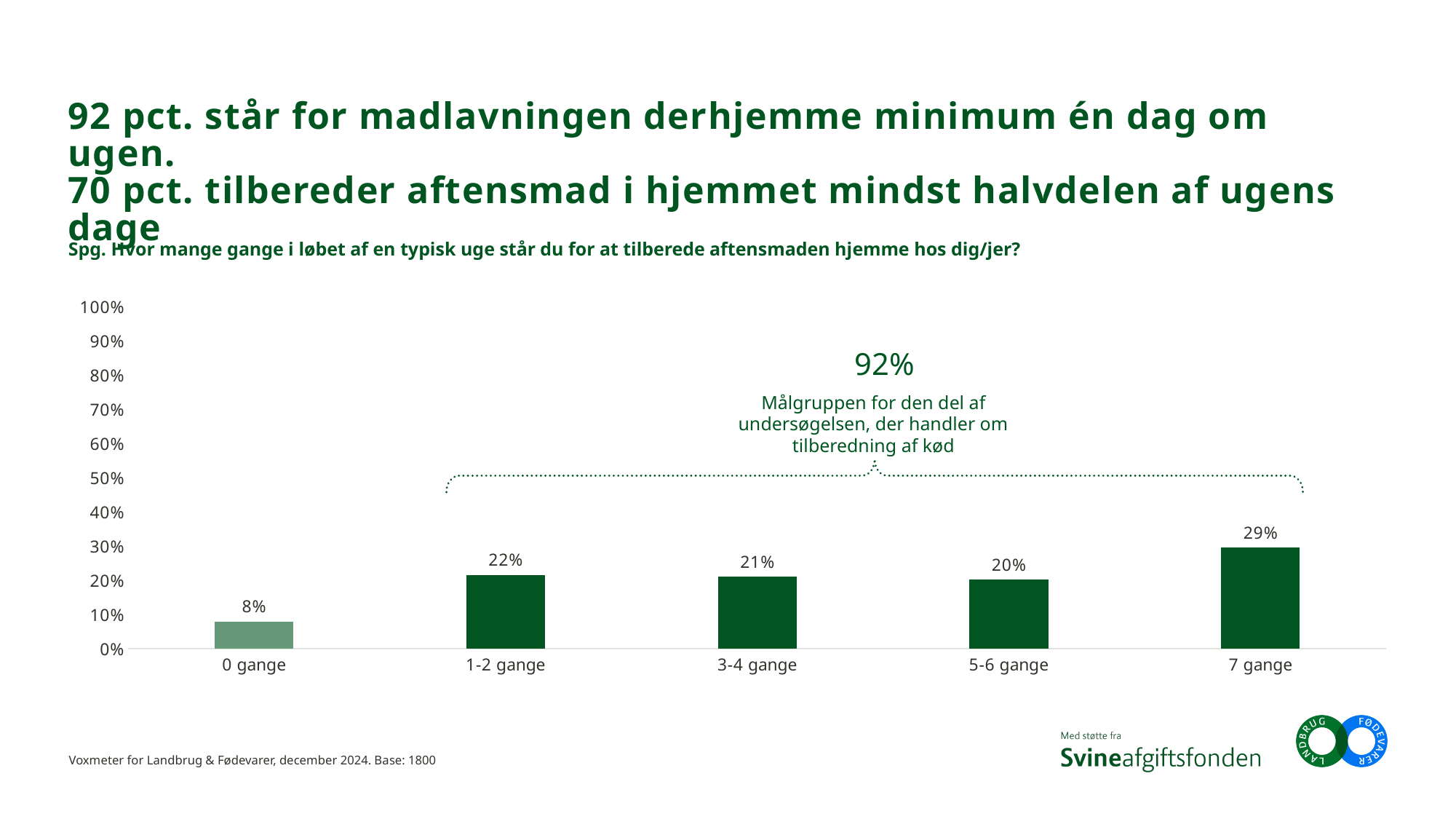
Which category has the highest value? 7 gange What is the value for "1-2 gange"? 22% What is the value for "7 gange"? 29% How many categories are shown on the x axis? 5 What is the difference between the values for "3-4 gange" and "5-6 gange"? 1% What kind of chart is shown on the slide? bar chart Is the value for "7 gange" greater or less than 20%? greater Which category has the lowest value? 0 gange What is the difference between the values for "7 gange" and "0 gange"? 21% Which is larger, the value for "1-2 gange" or the value for "5-6 gange"? 1-2 gange What percentage is shown above the dotted bracket spanning "1-2 gange" to "7 gange"? 92% What is the value for "0 gange"? 8%